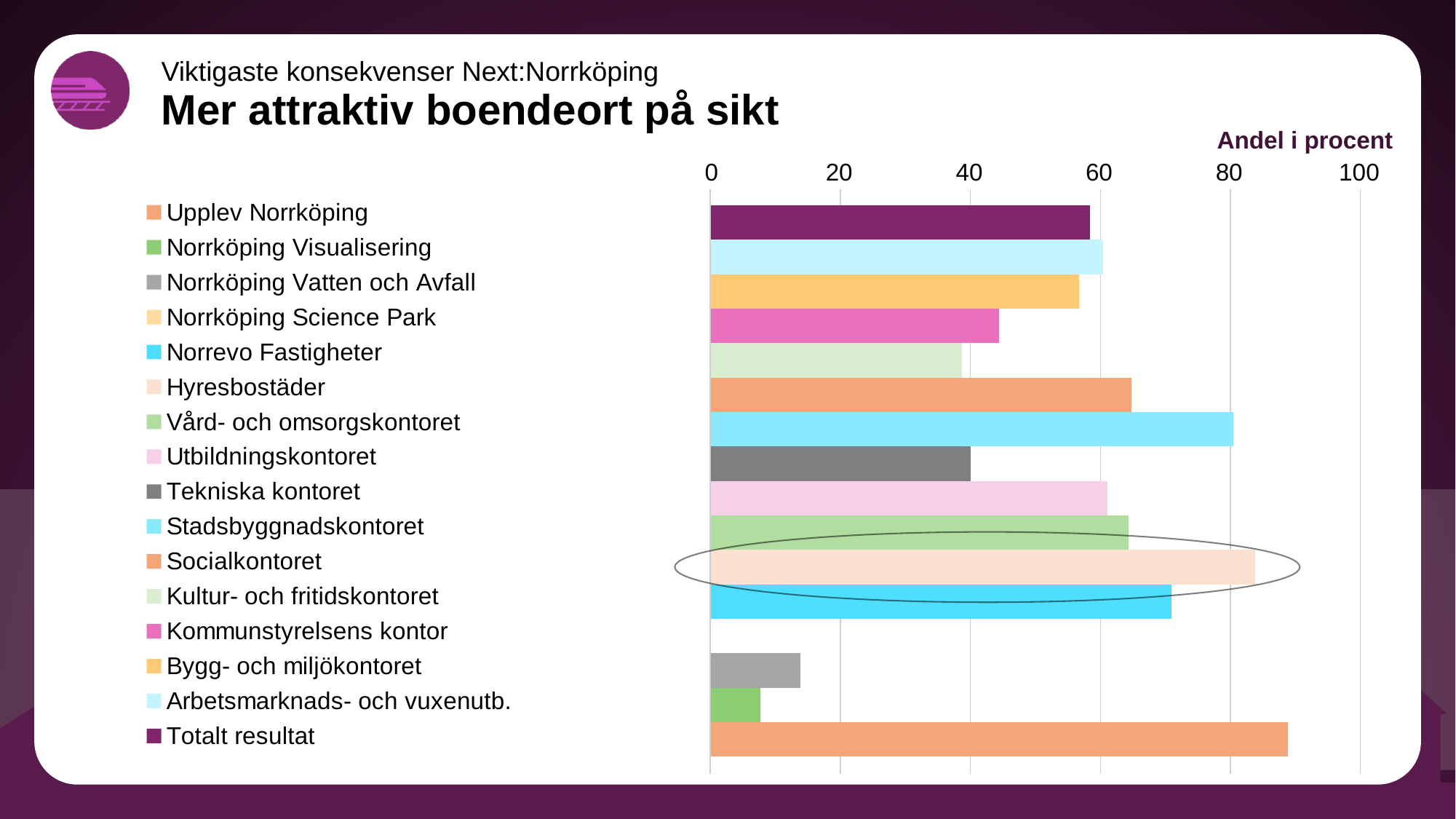
Which is larger, the value for Norrköping Vatten och Avfall or the value for Norrköping Visualisering? Norrköping Vatten och Avfall Is the value for Norrköping Vatten och Avfall greater or less than 20? less Is the value for Tekniska kontoret greater or less than 60? less Is the value for Hyresbostäder greater or less than 80? greater How many entries does the chart legend list? 16 Which category's bar is circled in the chart? Hyresbostäder Which is larger, the value for Stadsbyggnadskontoret or the value for Norrevo Fastigheter? Stadsbyggnadskontoret What label is shown above the horizontal axis of the chart? Andel i procent What kind of chart is shown on the slide? bar chart Which category has the longest bar in the chart? Upplev Norrköping